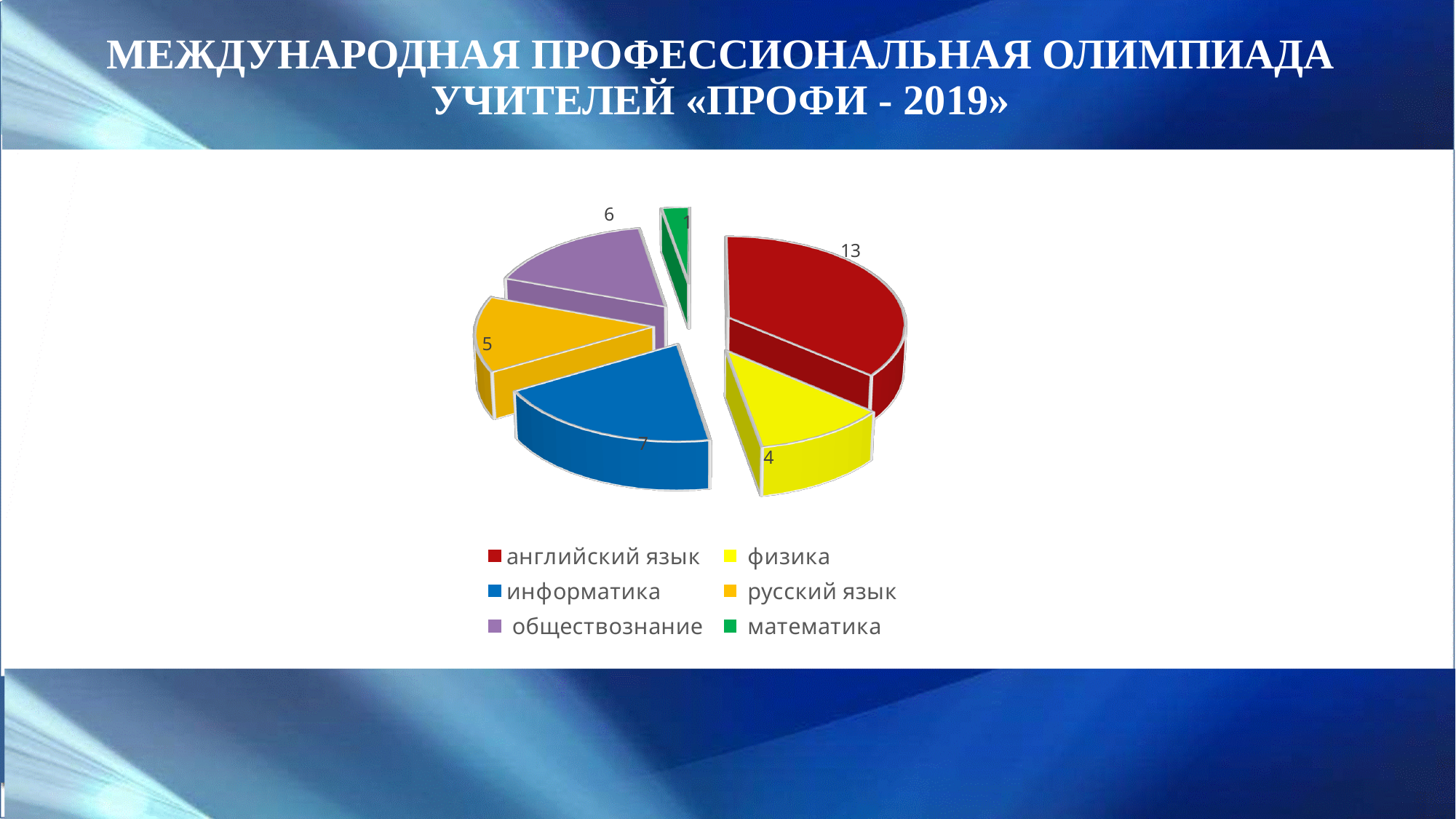
What is the value for обществознание? 6 What kind of chart is shown on the slide? pie chart What is the value for английский язык? 13 What is the total of all the slices in the pie chart? 36 Which category has the largest slice? английский язык Which is larger, the value for русский язык or the value for обществознание? обществознание What is the value for математика? 1 What is the difference between the values for английский язык and физика? 9 Which colour represents физика in the legend? yellow How many categories does the pie chart have? 6 Which category has the smallest slice? математика What is the value for информатика? 7